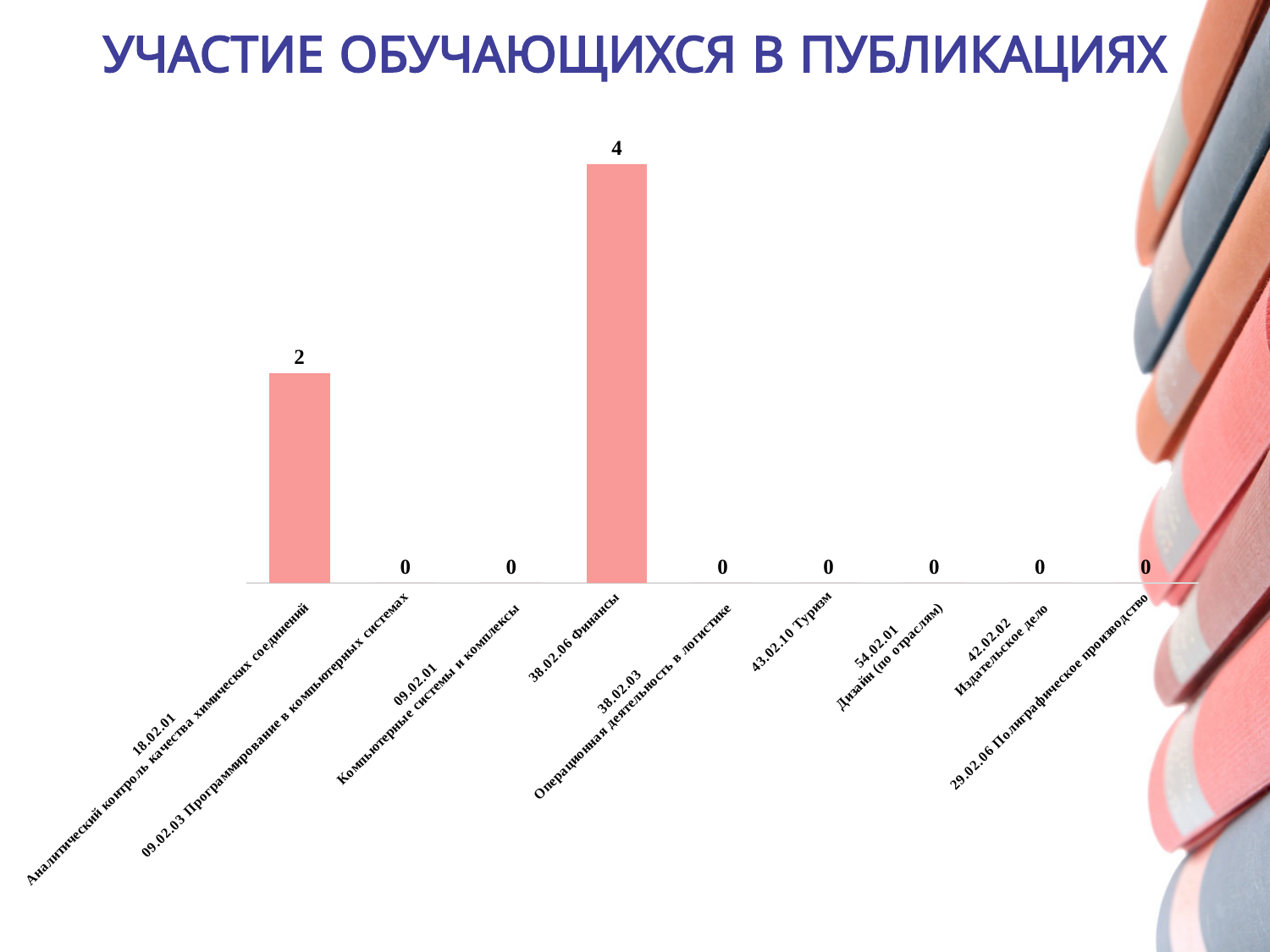
What value is shown for 43.02.10 Туризм? 0 How many categories have a value of 0? 7 Which is larger: the value for 38.02.06 Финансы or the value for 18.02.01 Аналитический контроль качества химических соединений? 38.02.06 Финансы What is the difference between the values for 38.02.06 Финансы and 18.02.01 Аналитический контроль качества химических соединений? 2 What value is shown for 09.02.03 Программирование в компьютерных системах? 0 Which category has the highest value? 38.02.06 Финансы What value is shown for 38.02.06 Финансы? 4 What kind of chart is shown on the slide? Bar chart What is the title of the slide? УЧАСТИЕ ОБУЧАЮЩИХСЯ В ПУБЛИКАЦИЯХ What value is shown for 18.02.01 Аналитический контроль качества химических соединений? 2 How many categories are shown on the x axis? 9 What value is shown for 29.02.06 Полиграфическое производство? 0